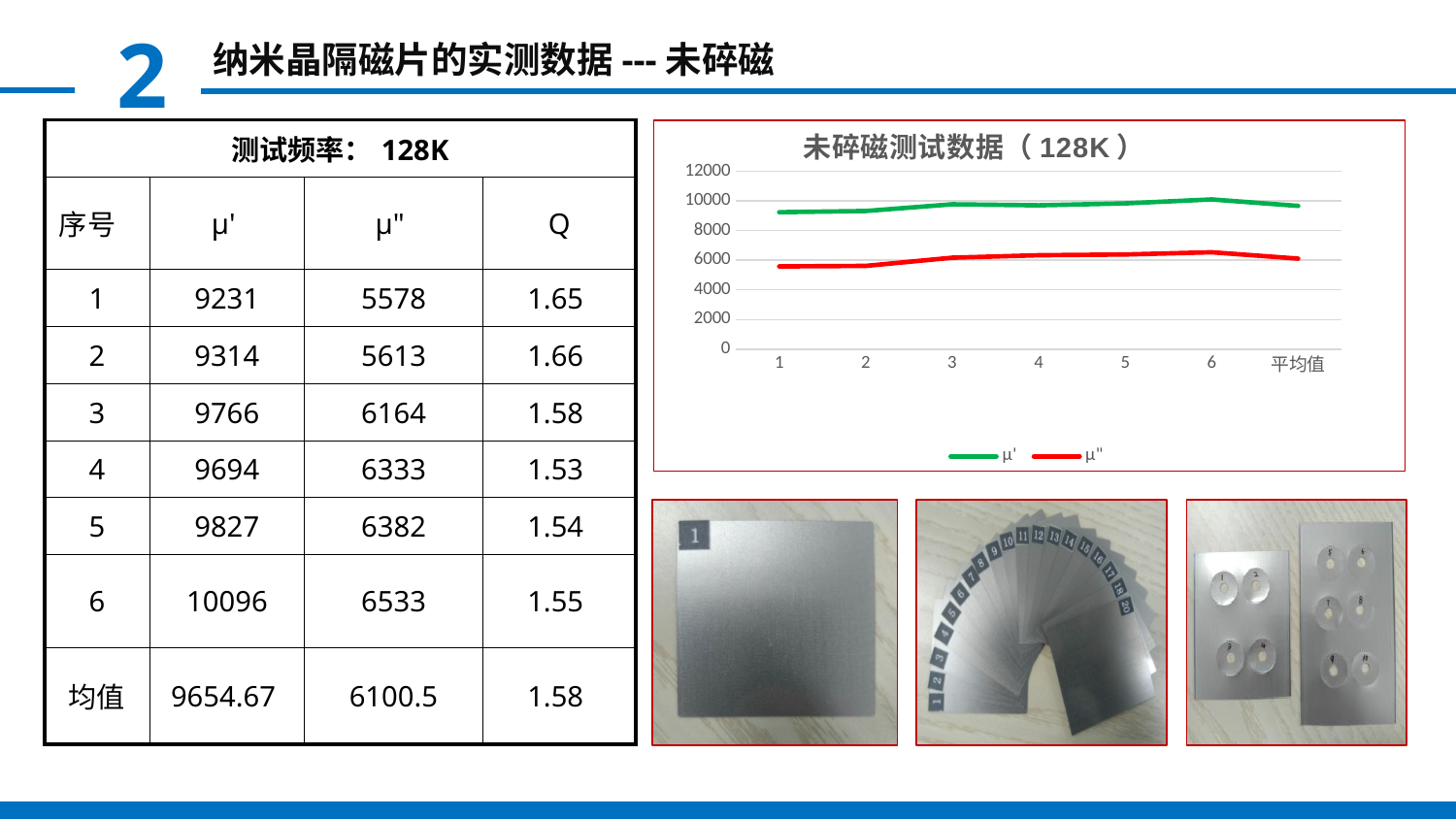
At which category does the μ' series reach its highest value? 6 How many series does the chart's legend list? 2 At category 4, which series has the larger value, μ' or μ"? μ' Is the value of μ" at category 6 greater or less than 8000? less Is the value of μ' at category 1 greater or less than 8000? greater What kind of chart is shown on the slide? line chart Is the value of μ" at category 1 greater or less than 6000? less How many categories are shown along the x axis of the chart? 7 Does the μ' series generally rise or fall from category 1 to category 6? rise According to the slide, what is the value of μ' at category 3? 9766 Which colour is used for the μ' series in the chart? green What is the title of the chart on the slide? 未碎磁测试数据（128K）